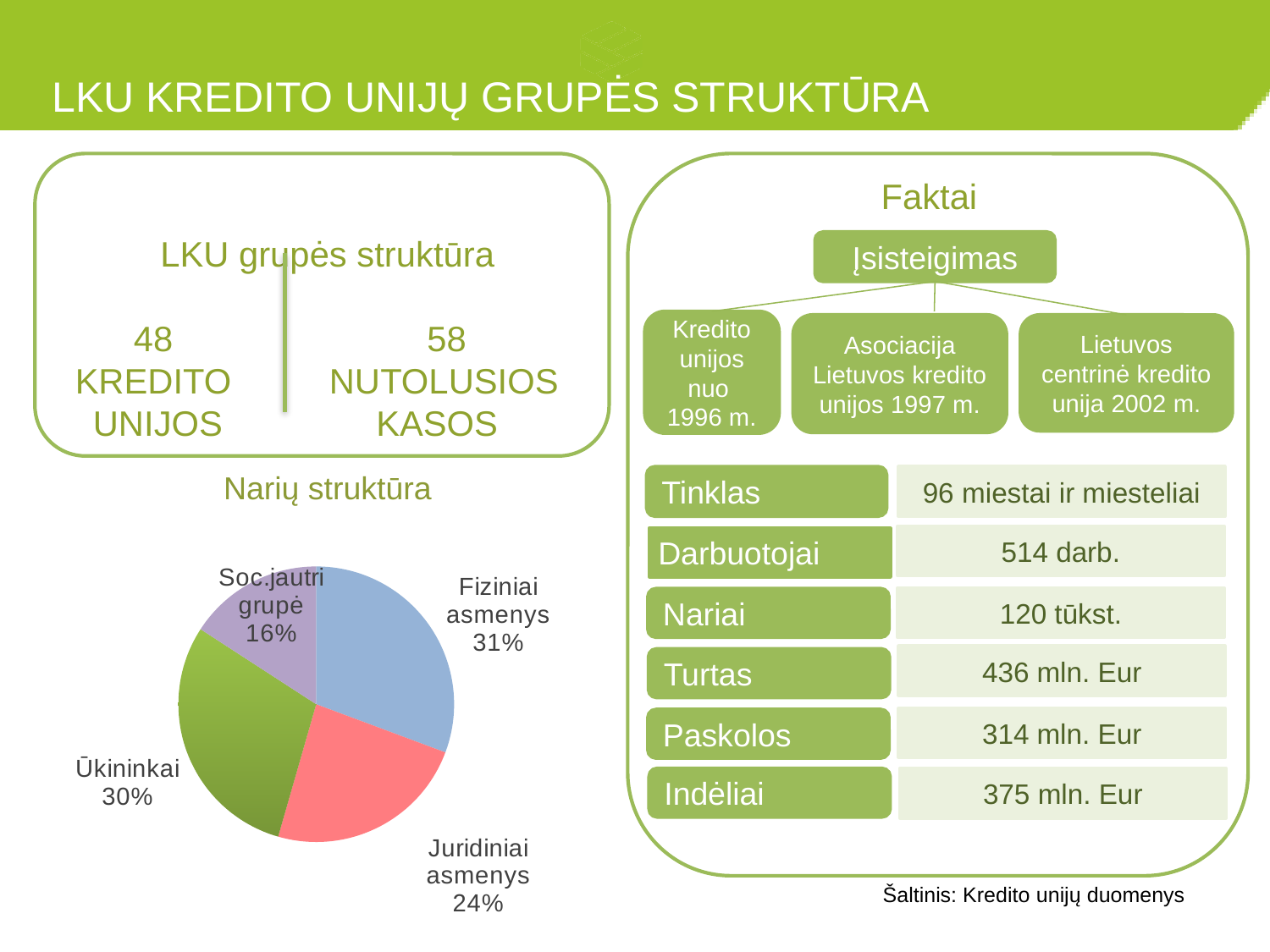
Which slice of the "Narių struktūra" pie chart is the smallest? Soc.jautri grupė What is the title of the pie chart on the slide? Narių struktūra In the "Narių struktūra" pie chart, which is larger: Ūkininkai or Juridiniai asmenys? Ūkininkai In the "Narių struktūra" pie chart, what share does Soc.jautri grupė have? 16% In the "Narių struktūra" pie chart, what share do Juridiniai asmenys have? 24% Which slice of the "Narių struktūra" pie chart is the largest? Fiziniai asmenys In the "Narių struktūra" pie chart, what is the difference in percentage points between Ūkininkai and Juridiniai asmenys? 6 percentage points What kind of chart is shown under "Narių struktūra"? pie chart In the "Narių struktūra" pie chart, what share do Fiziniai asmenys have? 31% In the "Narių struktūra" pie chart, what share do Ūkininkai have? 30% How many slices does the "Narių struktūra" pie chart have? 4 In the "Narių struktūra" pie chart, what is the difference in percentage points between Fiziniai asmenys and Soc.jautri grupė? 15 percentage points